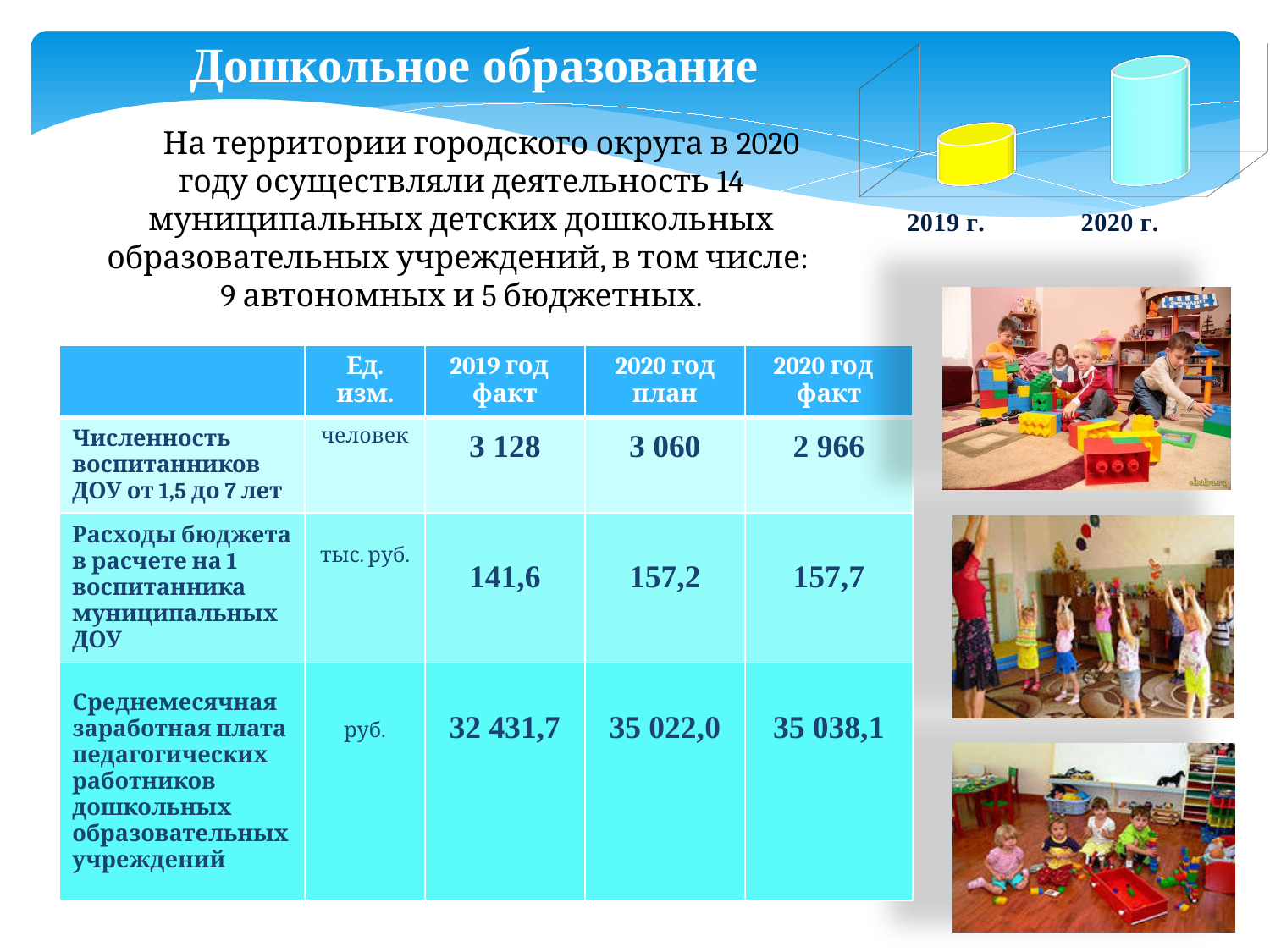
What colour is the bar for 2020 г. in the chart in the top right? light blue In the chart in the top right, which category has the taller bar, 2019 г. or 2020 г.? 2020 г. How many categories does the chart in the top right show? 2 In the chart in the top right, which category has the lowest bar? 2019 г. In the chart in the top right, do the bars rise or fall from 2019 г. to 2020 г.? rise In the chart in the top right, which category has the highest bar? 2020 г. What kind of chart is shown in the top right of the slide? bar chart What colour is the bar for 2019 г. in the chart in the top right? yellow